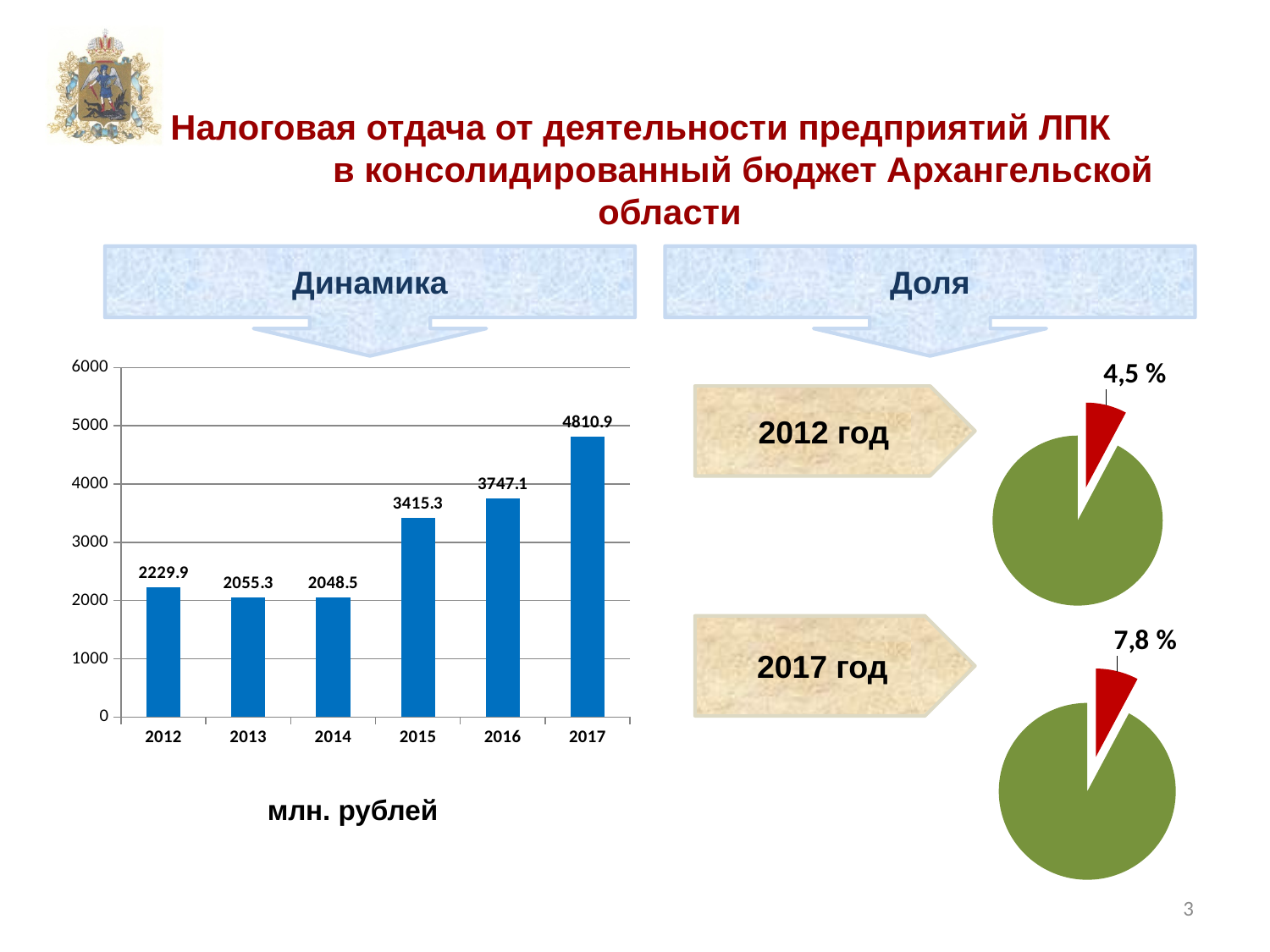
In the pie chart for "2012 год", what share does the red slice represent? 4,5 % How many years are shown in the bar chart under "Динамика"? 6 In the bar chart under "Динамика", which is larger, the value for 2012 or the value for 2013? 2012 In the bar chart under "Динамика", what is the value for 2017? 4810.9 In the bar chart under "Динамика", what is the difference between the values for 2017 and 2016? 1063.8 In the bar chart under "Динамика", what is the value for 2014? 2048.5 What kind of chart is shown under "Динамика"? bar chart In the bar chart under "Динамика", which year has the highest value? 2017 In the bar chart under "Динамика", which year has the lowest value? 2014 In the bar chart under "Динамика", do the values rise or fall from 2014 to 2017? rise In the bar chart under "Динамика", is the value for 2015 greater or less than 3000? greater In the pie chart for "2017 год", what share does the red slice represent? 7,8 %